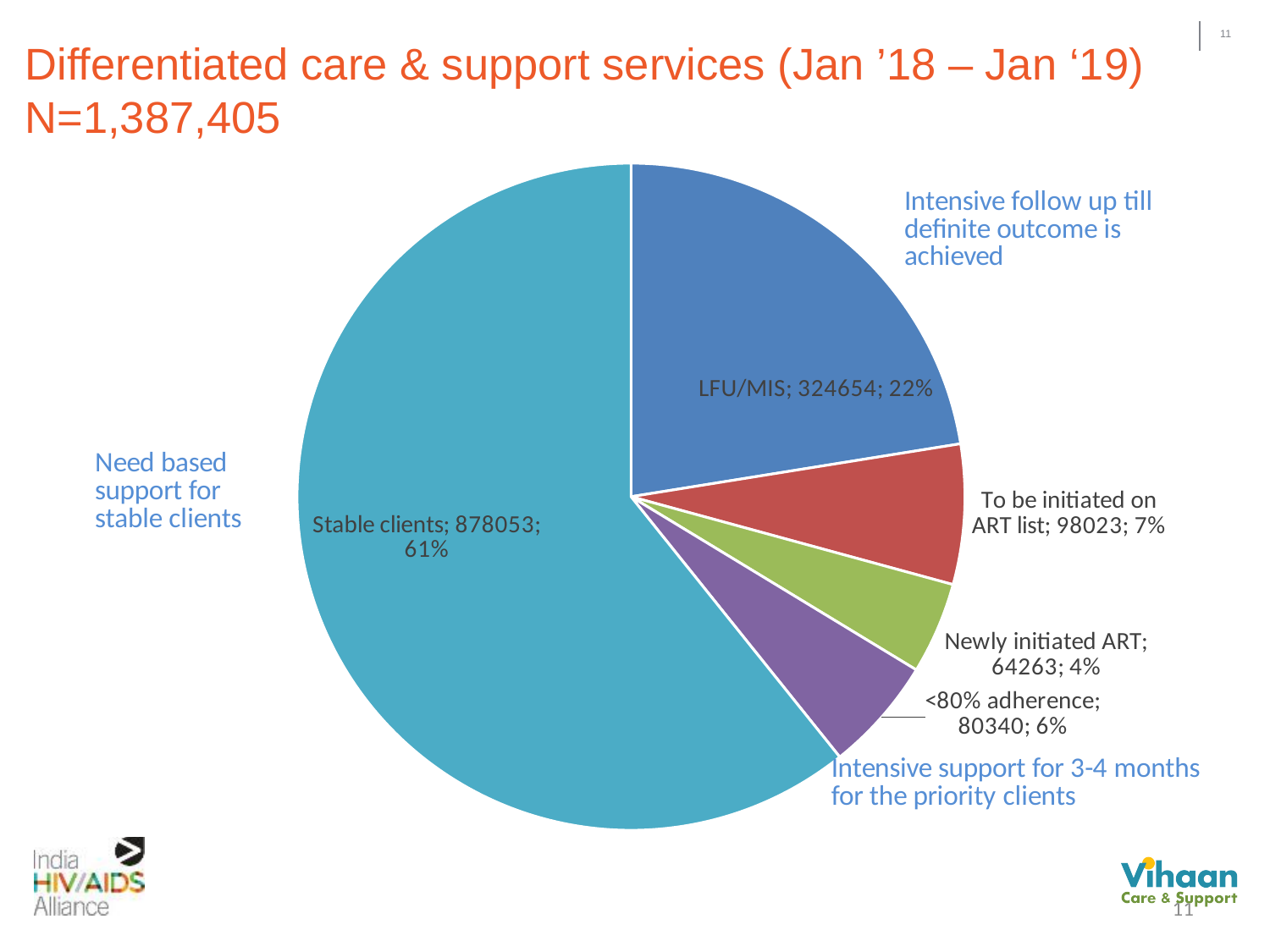
What is the value for Stable clients? 878053 What kind of chart is shown on the slide? Pie chart Which category has the largest slice? Stable clients What percentage of the pie is LFU/MIS? 22% How many slices does the pie chart have? 5 What share of the pie is <80% adherence? 6% What is the value for Newly initiated ART? 64263 What is the N value stated in the slide title? 1,387,405 Which is larger, the value for <80% adherence or the value for Newly initiated ART? <80% adherence What is the value for To be initiated on ART list? 98023 Which category has the smallest slice? Newly initiated ART What is the difference between the values for LFU/MIS and To be initiated on ART list? 226631